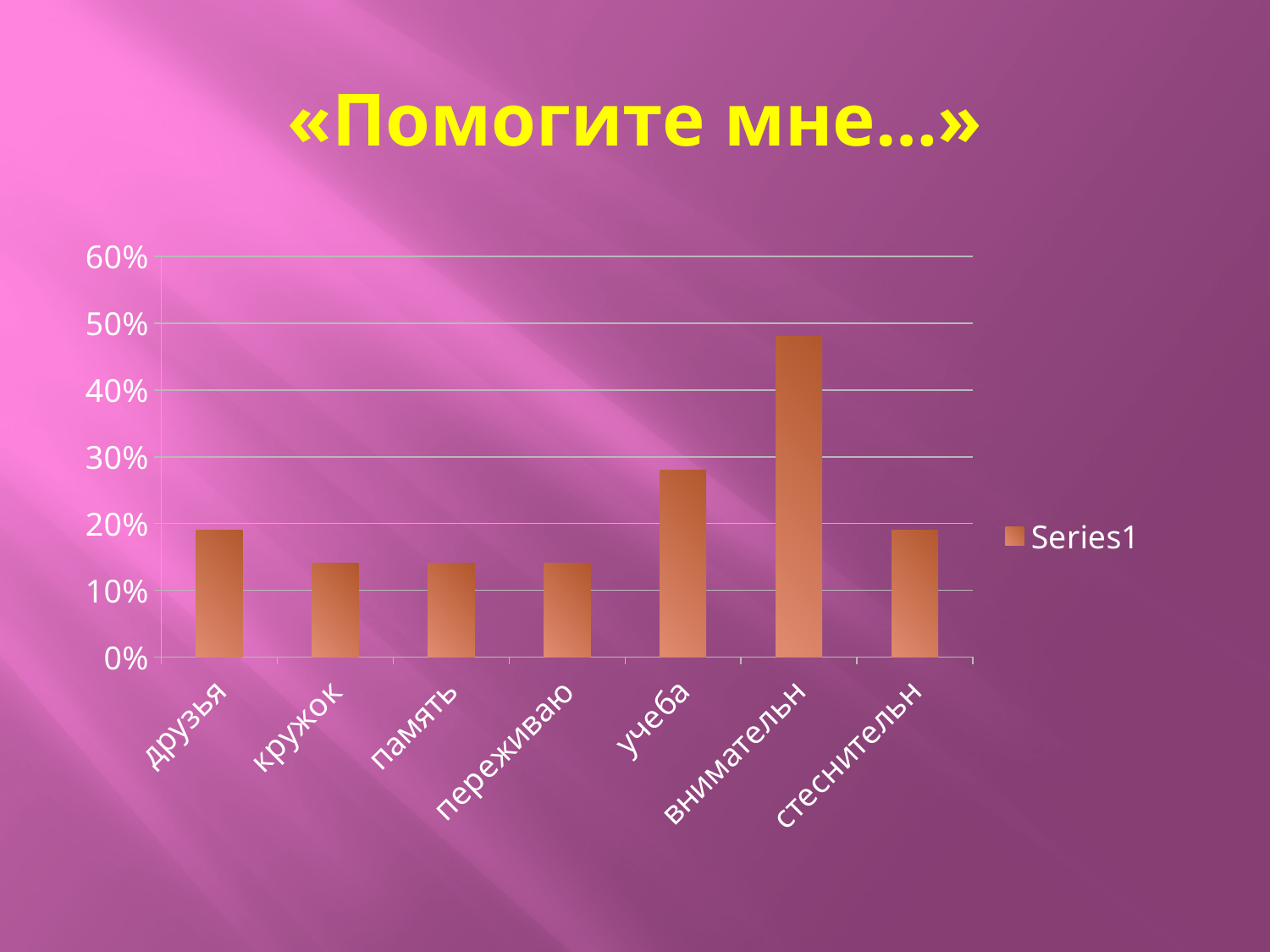
How many series does the legend list? 1 Which category has the highest value? внимательн Is the value for учеба greater or less than 30%? less How many categories are shown on the x axis of the chart? 7 Is the value for кружок greater or less than 10%? greater Is the value for внимательн greater or less than 40%? greater What is the title of the slide above the chart? «Помогите мне…» Which is larger, the value for внимательн or the value for учеба? внимательн What kind of chart is shown on the slide? bar chart What is the name of the series shown in the legend? Series1 Which is larger, the value for учеба or the value for кружок? учеба